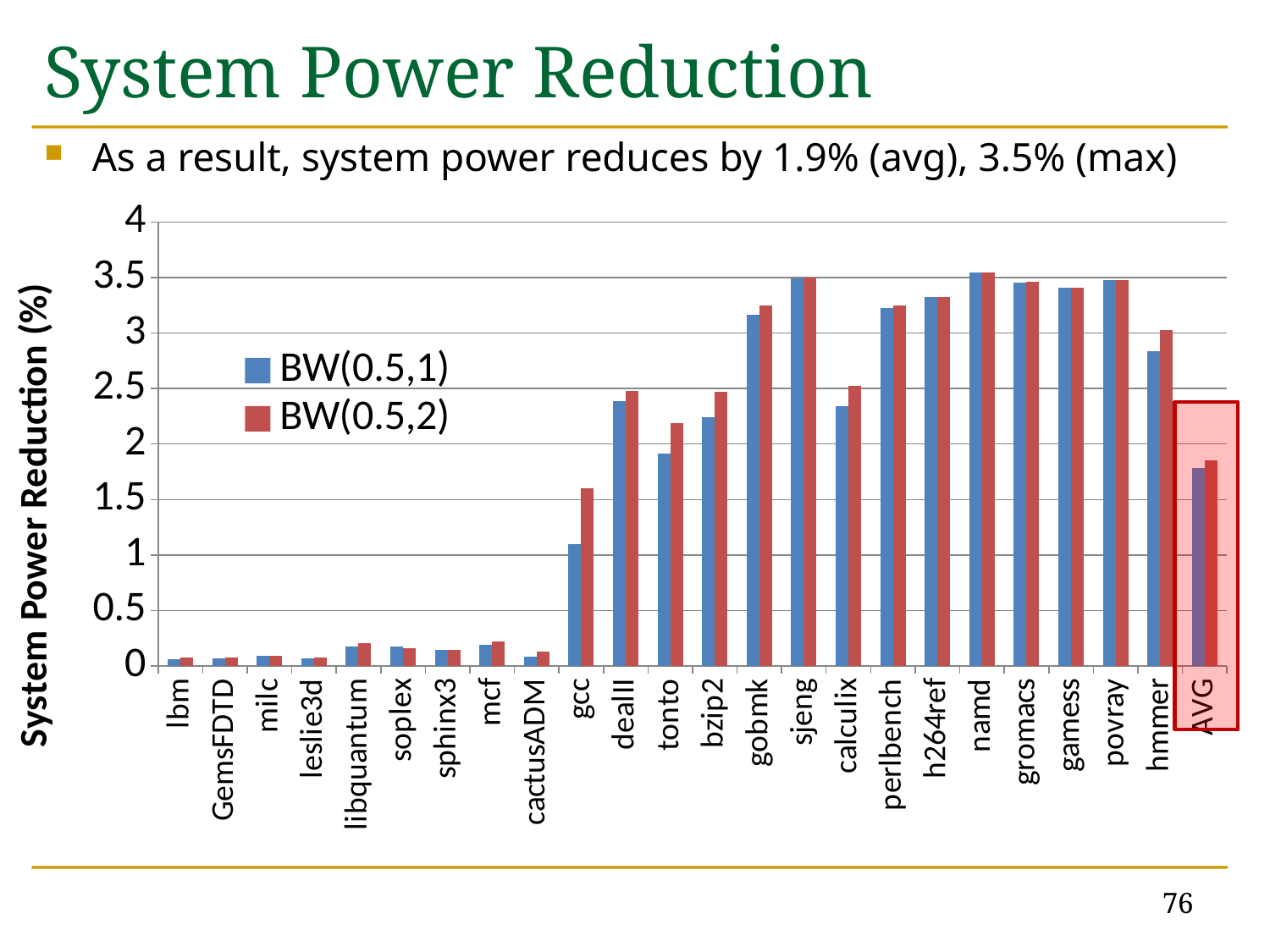
Is the BW(0.5,2) value for gcc greater or less than 1? greater What is the label of the y axis? System Power Reduction (%) Is the BW(0.5,1) value for sjeng greater or less than 3? greater What kind of chart is shown on the slide? bar chart How many series does the legend list? 2 Is the BW(0.5,1) value for gcc greater or less than 1.5? less For the BW(0.5,1) series, which is larger, gcc or dealII? dealII For gcc, which series has the larger value, BW(0.5,1) or BW(0.5,2)? BW(0.5,2) How many categories are shown along the x axis? 24 Which category on the x axis is highlighted with a red box? AVG